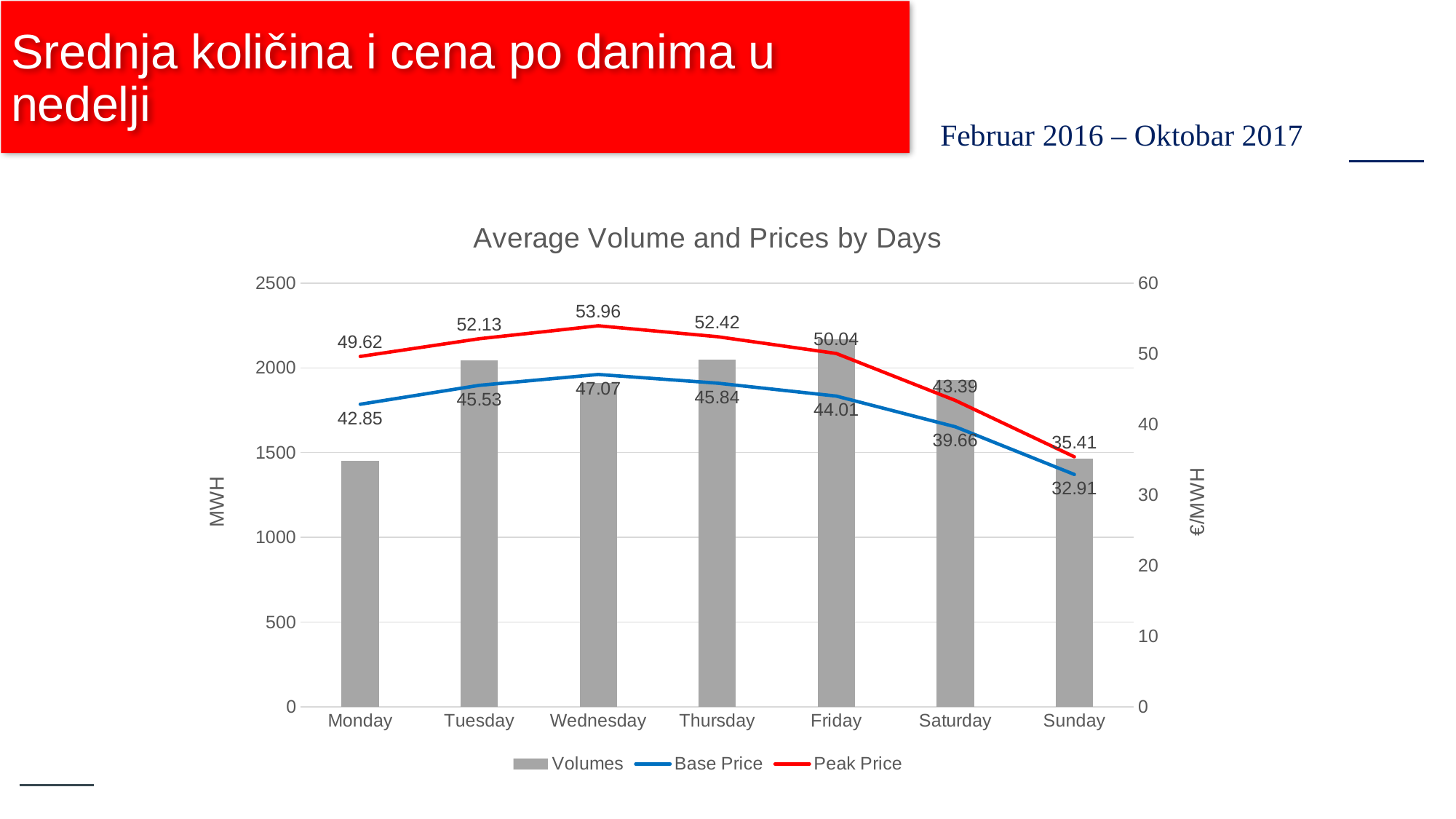
Which day has the higher Base Price, Tuesday or Thursday? Thursday Is the Volumes value for Saturday greater or less than 1500? greater What is the Peak Price for Wednesday? 53.96 What is the Base Price for Sunday? 32.91 What kind of chart is this? Combination bar and line chart How many days are shown on the x axis? 7 On which day is the Peak Price highest? Wednesday Is the Volumes value for Friday greater or less than 2000? greater Does the Peak Price rise or fall from Wednesday to Sunday? Fall How many series does the legend list? 3 What is the difference between the Peak Price and the Base Price on Friday? 6.03 On which day is the Base Price lowest? Sunday